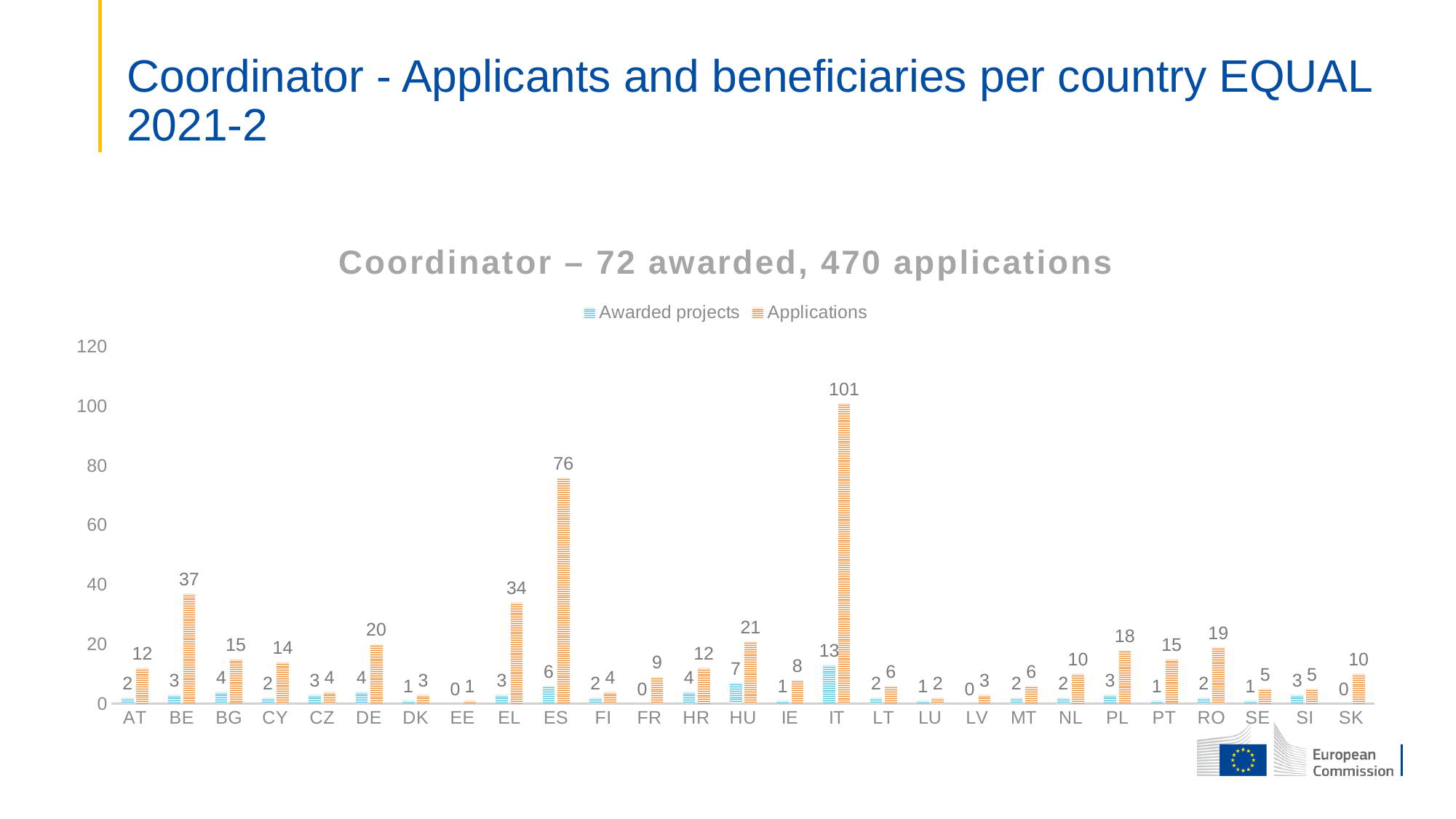
Which has more applications, BE or DE? BE What is the difference between the applications for ES and for EL? 42 How many series does the legend list? 2 How many awarded projects does ES have? 6 How many countries are shown on the x axis? 27 How many applications did HU receive? 21 Which country has the highest number of applications? IT Which country has the highest number of awarded projects? IT Is the value for applications for ES greater or less than 60? greater What kind of chart is shown on the slide? bar chart How many applications did IT receive? 101 What is the title of the chart? Coordinator – 72 awarded, 470 applications